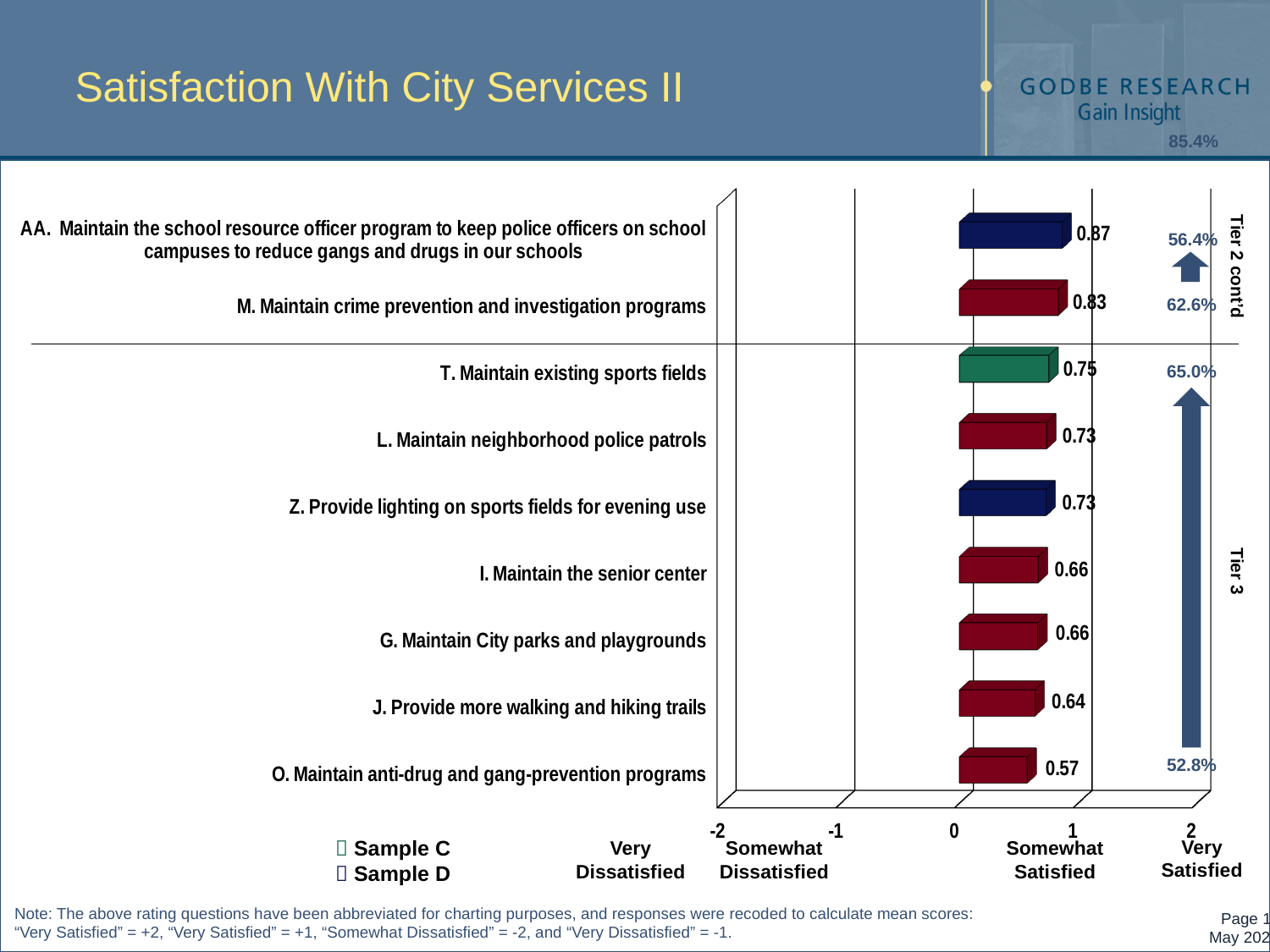
What is the difference between the mean scores for 'AA. Maintain the school resource officer program' and 'O. Maintain anti-drug and gang-prevention programs'? 0.30 What is the mean score for 'J. Provide more walking and hiking trails'? 0.64 What is the mean score for 'T. Maintain existing sports fields'? 0.75 How many items are plotted in the chart? 9 Which item has the highest mean score? AA. Maintain the school resource officer program to keep police officers on school campuses to reduce gangs and drugs in our schools Which item has the lowest mean score? O. Maintain anti-drug and gang-prevention programs What is the mean score for 'M. Maintain crime prevention and investigation programs'? 0.83 How many entries does the legend list? 2 What is the title of the slide? Satisfaction With City Services II Which has a higher mean score: 'L. Maintain neighborhood police patrols' or 'I. Maintain the senior center'? L. Maintain neighborhood police patrols What type of chart is shown on the slide? Bar chart Is the mean score for 'Z. Provide lighting on sports fields for evening use' greater or less than 1? less